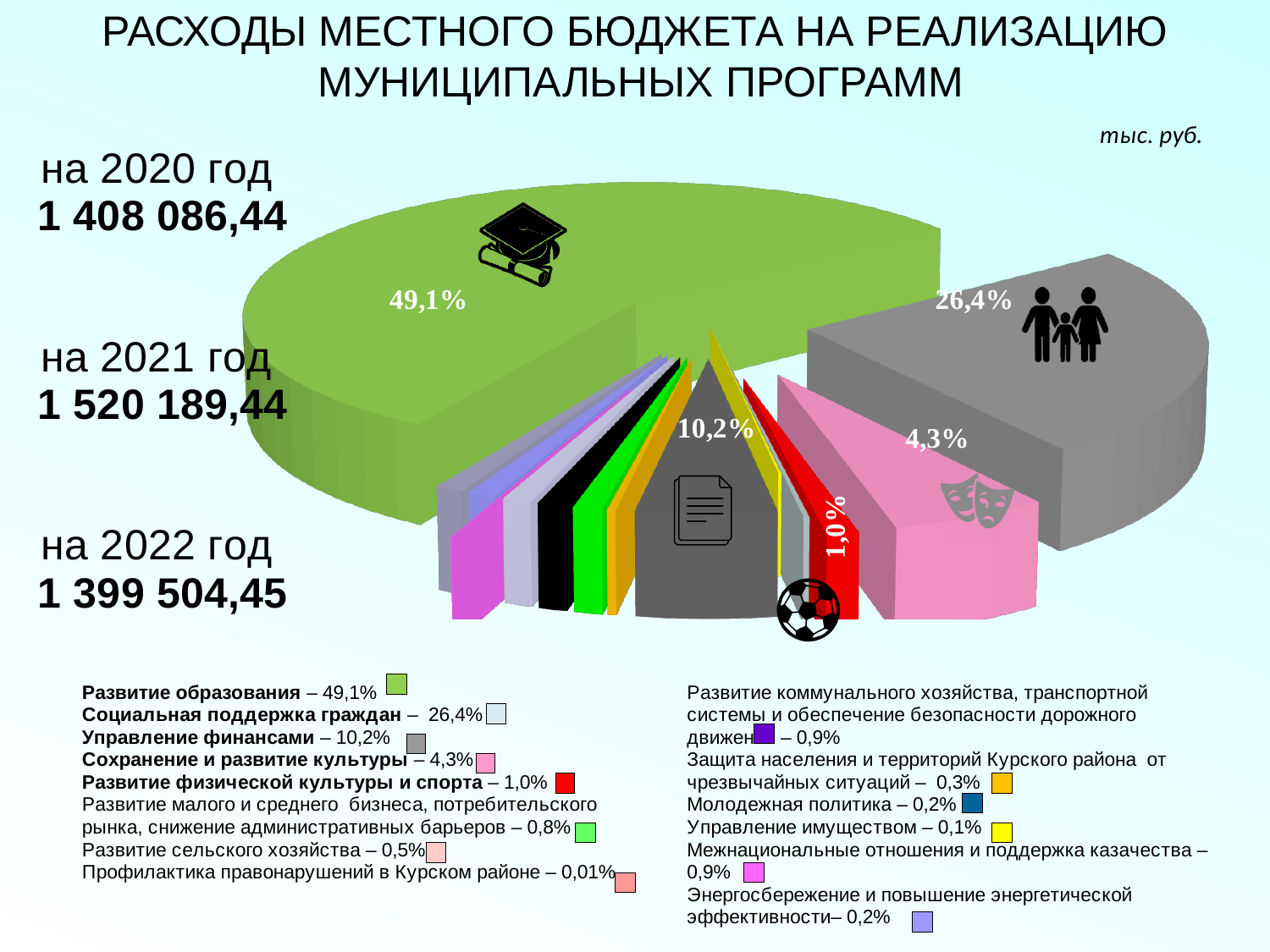
Which program has the largest slice of the pie chart? Развитие образования What is the difference in percentage points between Развитие образования and Социальная поддержка граждан? 22,7 What is the difference in percentage points between Управление финансами and Сохранение и развитие культуры? 5,9 What percentage is shown for Социальная поддержка граждан? 26,4% What share of the pie chart does Развитие образования account for? 49,1% Which program has the smallest share in the legend? Профилактика правонарушений в Курском районе In what units are the budget figures on the slide given? тыс. руб. What percentage is given for Защита населения и территорий Курского района от чрезвычайных ситуаций? 0,3% How many programs are listed in the legend of the chart? 14 What kind of chart is shown on the slide? Pie chart Which has a larger share: Управление финансами or Сохранение и развитие культуры? Управление финансами What percentage is shown for Развитие физической культуры и спорта? 1,0%